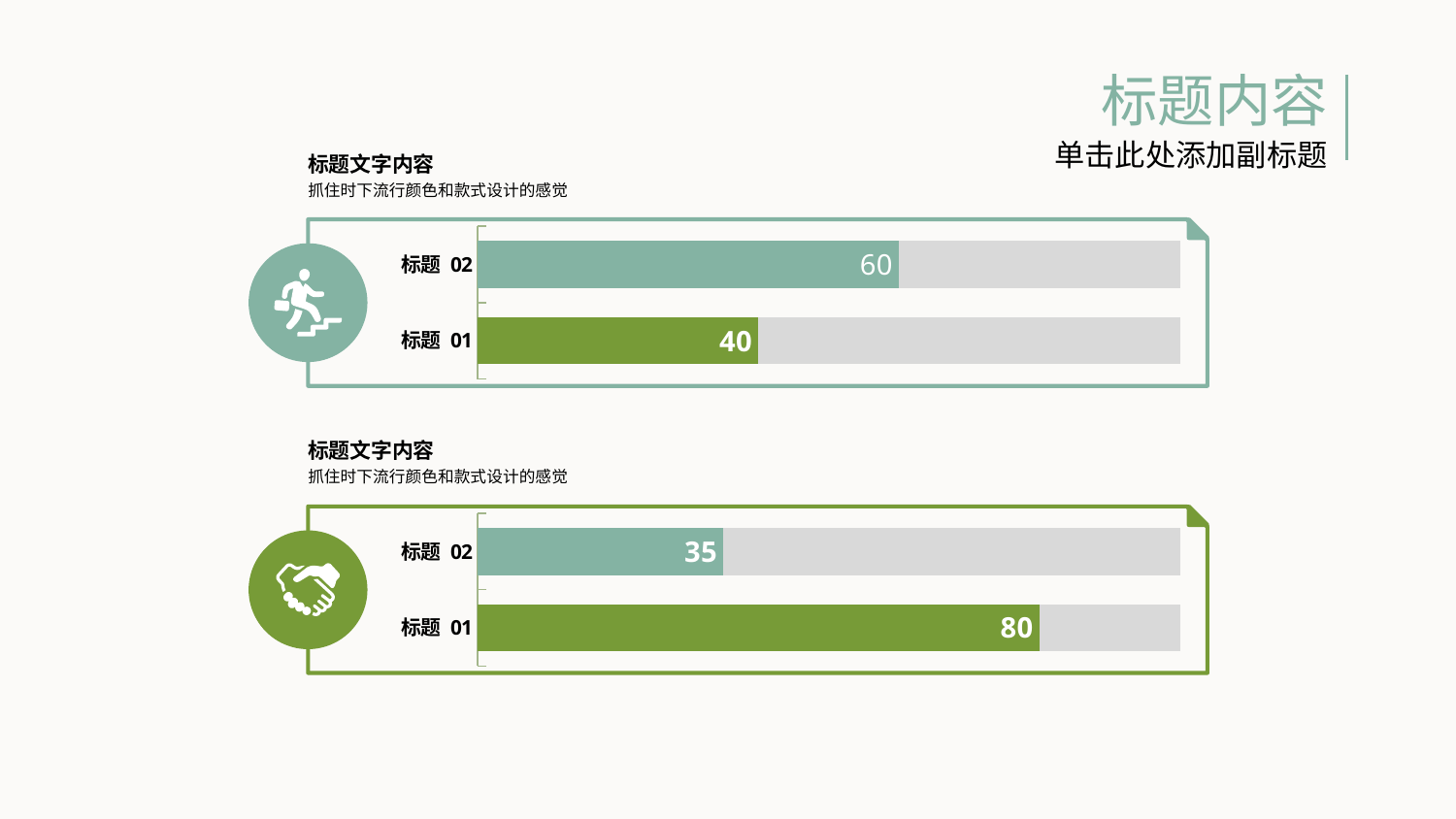
In the bottom chart, what is the value for 标题 01? 80 In the top chart, what colour is the bar for 标题 01? green In the bottom chart, which category has the lowest value? 标题 02 In the top chart, which category has the highest value? 标题 02 How many categories are shown in the top chart? 2 What kind of chart is the bottom chart? bar chart In the top chart, what is the value for 标题 01? 40 In the bottom chart, which is larger, the value for 标题 01 or 标题 02? 标题 01 In the bottom chart, what is the difference between the values for 标题 01 and 标题 02? 45 In the bottom chart, what is the value for 标题 02? 35 In the top chart, what is the difference between the values for 标题 02 and 标题 01? 20 In the top chart, what is the value for 标题 02? 60